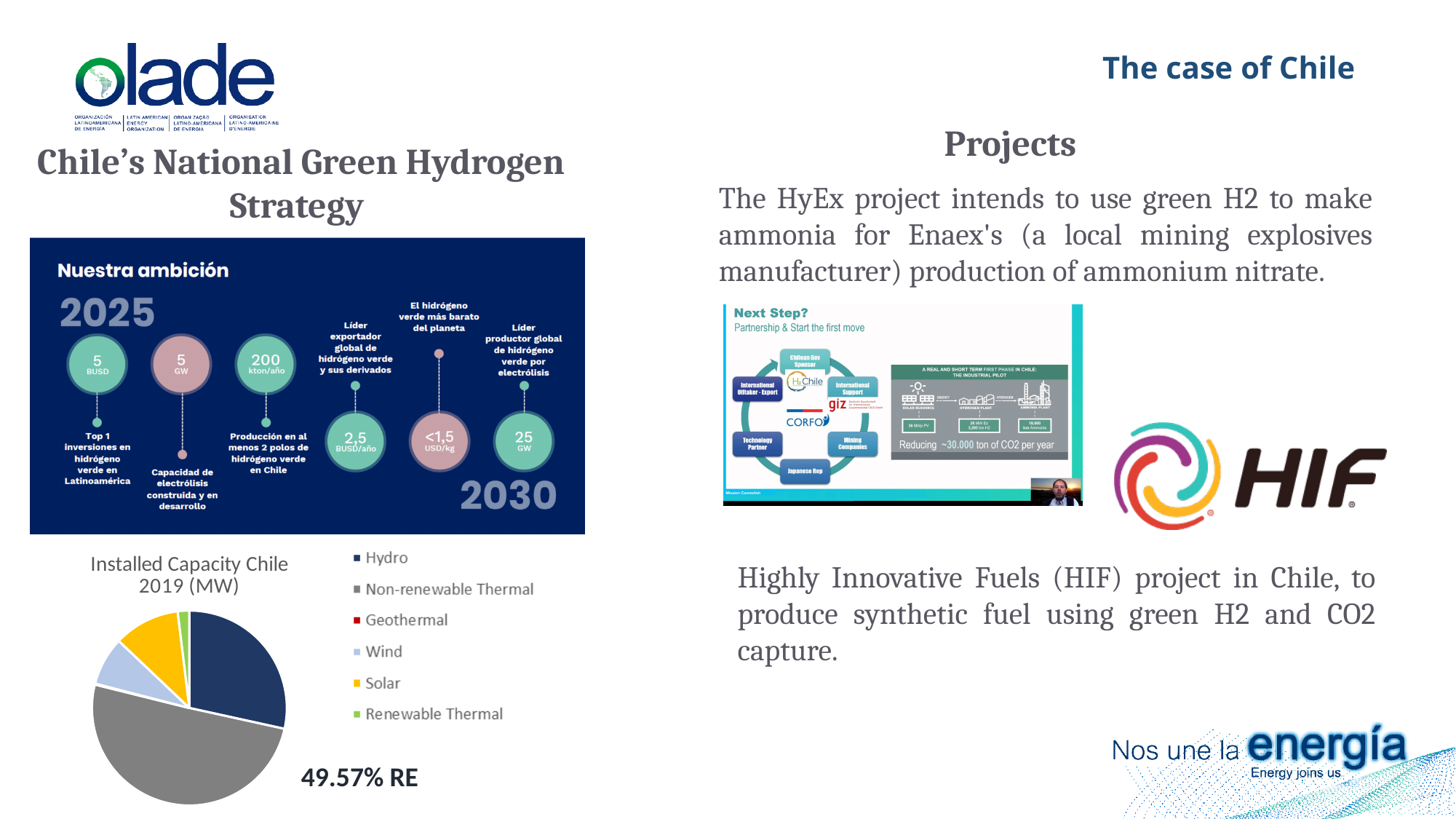
How many categories does the legend of the Installed Capacity Chile 2019 (MW) pie chart list? 6 What is the title of the pie chart on the slide? Installed Capacity Chile 2019 (MW) What kind of chart is the Installed Capacity Chile 2019 (MW) chart? pie chart What renewable energy share is printed next to the Installed Capacity Chile 2019 (MW) pie chart? 49.57% RE In the Installed Capacity Chile 2019 (MW) pie chart, which slice is larger, Non-renewable Thermal or Hydro? Non-renewable Thermal Which category has the largest slice in the Installed Capacity Chile 2019 (MW) pie chart? Non-renewable Thermal In the Installed Capacity Chile 2019 (MW) pie chart, which slice is larger, Hydro or Solar? Hydro In the Installed Capacity Chile 2019 (MW) pie chart, which slice is larger, Wind or Renewable Thermal? Wind